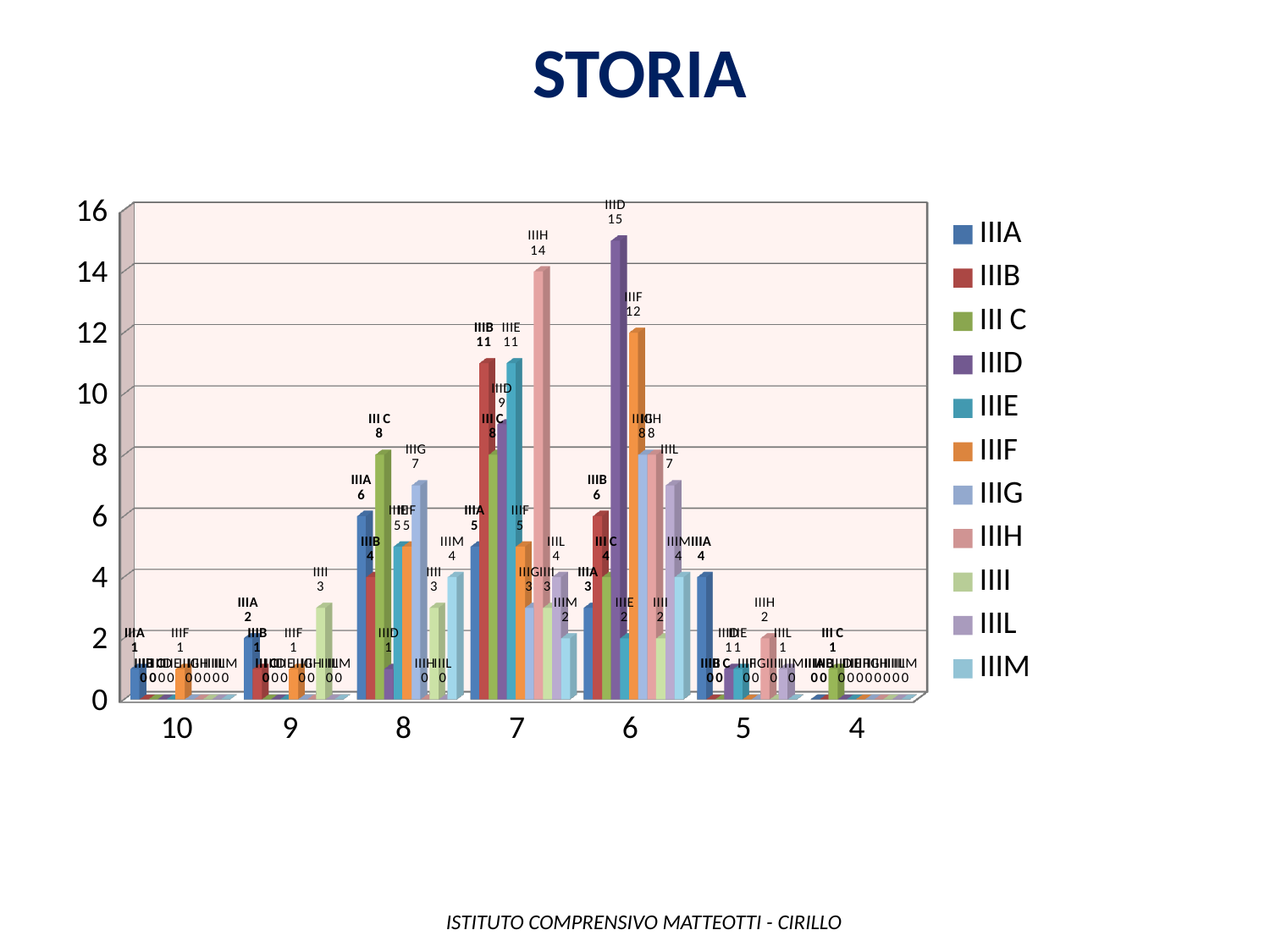
What is the value for IIIA in category 9? 2 How many series does the legend list? 11 Which is larger: the IIIB value in category 7 or the IIIB value in category 6? IIIB in category 7 What kind of chart is shown on the slide? bar chart Which series has the highest value in category 6? IIID What is the value for IIIH in category 7? 14 How many categories are shown on the x axis? 7 What is the difference between the IIIF value in category 6 and the IIIF value in category 7? 7 What is the value for III C in category 8? 8 What is the value for IIIG in category 8? 7 What is the title of the chart? STORIA What is the value for IIID in category 6? 15